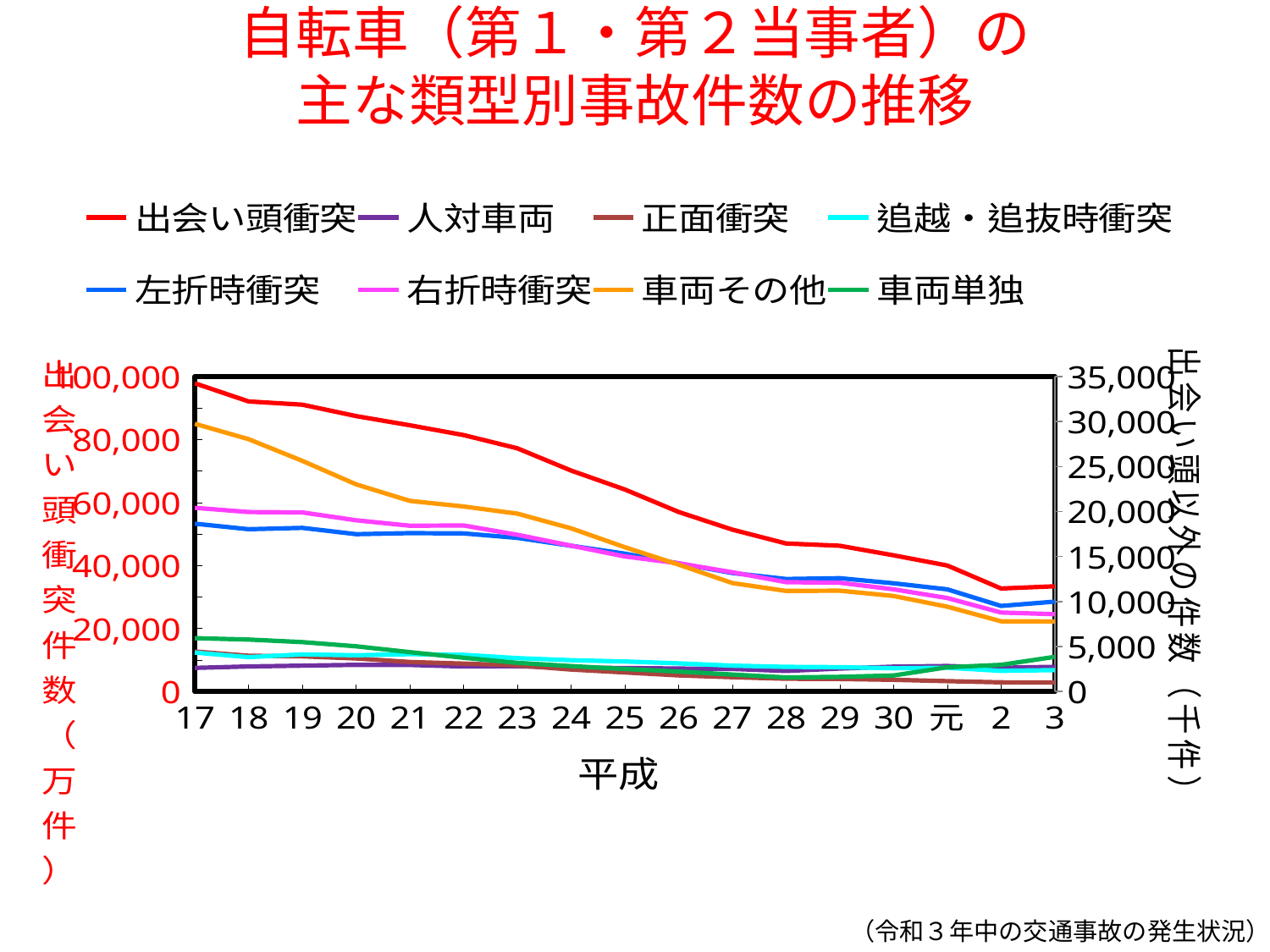
On the right axis, is the value for 車両その他 at 17 greater or less than 25,000? greater How many series does the legend list? 8 On the left axis, is the value for 出会い頭衝突 at 17 greater or less than 80,000? greater Which series has the highest value at 17? 出会い頭衝突 What colour is the 出会い頭衝突 line in the legend? red Does the 車両その他 line rise or fall from 17 to 3? fall Which series has the lowest value at 3? 正面衝突 At 17, which is larger: 車両その他 or 左折時衝突? 車両その他 Does the 出会い頭衝突 line rise or fall from 17 to 3? fall How many points are plotted along the x axis (from 17 to 3)? 17 On the left axis, is the value for 出会い頭衝突 at 3 greater or less than 40,000? less What kind of chart is shown on the slide? line chart